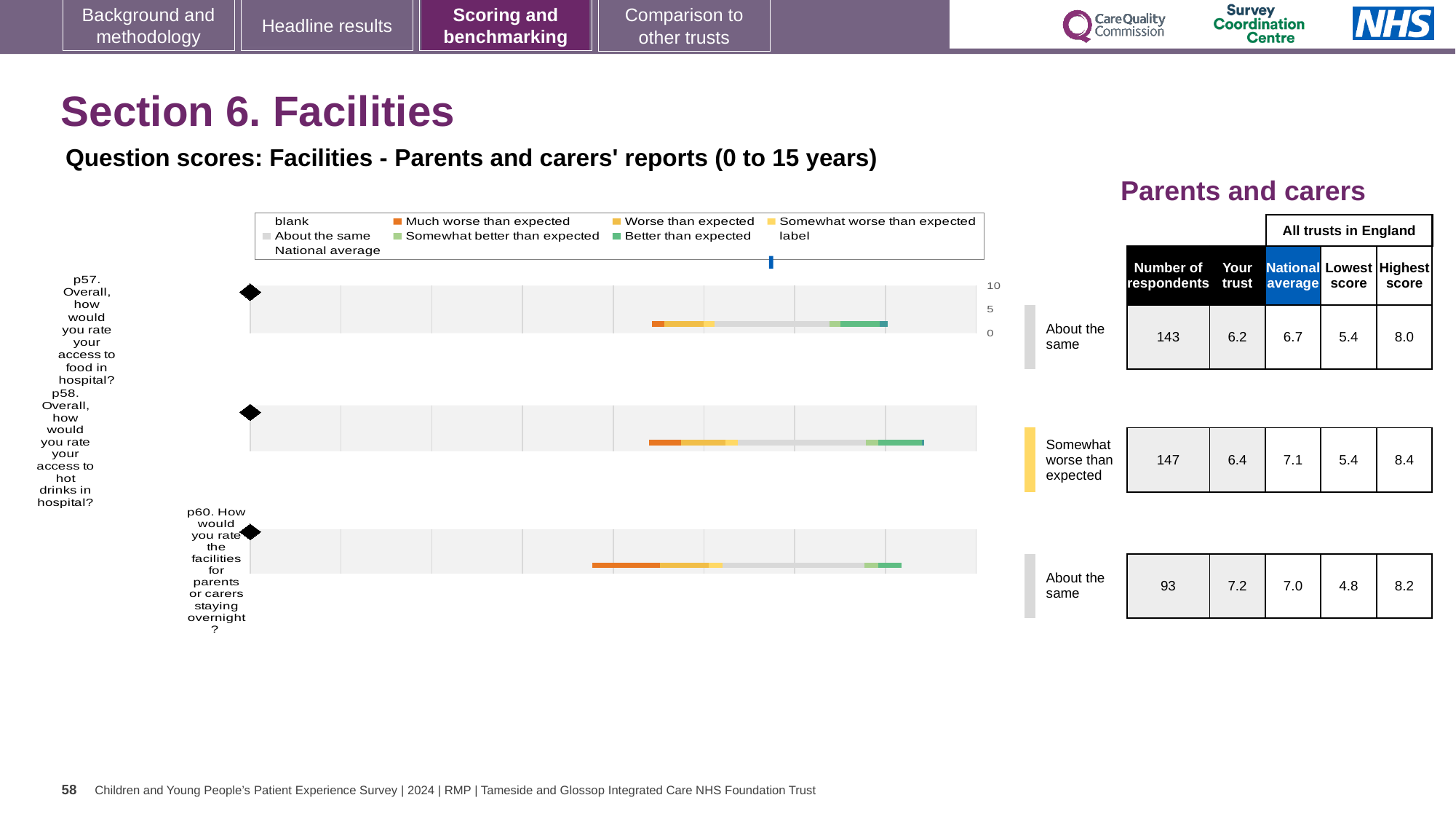
Which question has the fewest respondents? p60 (facilities for parents or carers staying overnight) How many questions (bars) are plotted in the chart? 3 What is the 'Your trust' score for p57 (access to food in hospital)? 6.2 Which benchmark category is shown for p58 (access to hot drinks in hospital)? Somewhat worse than expected What is the highest score across all trusts in England for p58 (access to hot drinks in hospital)? 8.4 For p60 (facilities for parents or carers staying overnight), is the 'Your trust' score higher or lower than the national average? Higher What is the lowest score across all trusts in England for p60 (facilities for parents or carers staying overnight)? 4.8 Which question has the highest 'Your trust' score? p60 (facilities for parents or carers staying overnight) What is the difference between the national average and the 'Your trust' score for p58 (access to hot drinks in hospital)? 0.7 What kind of chart is used to show the question scores on this slide? Bar chart How many respondents answered p60 (facilities for parents or carers staying overnight)? 93 What is the national average for p58 (access to hot drinks in hospital)? 7.1